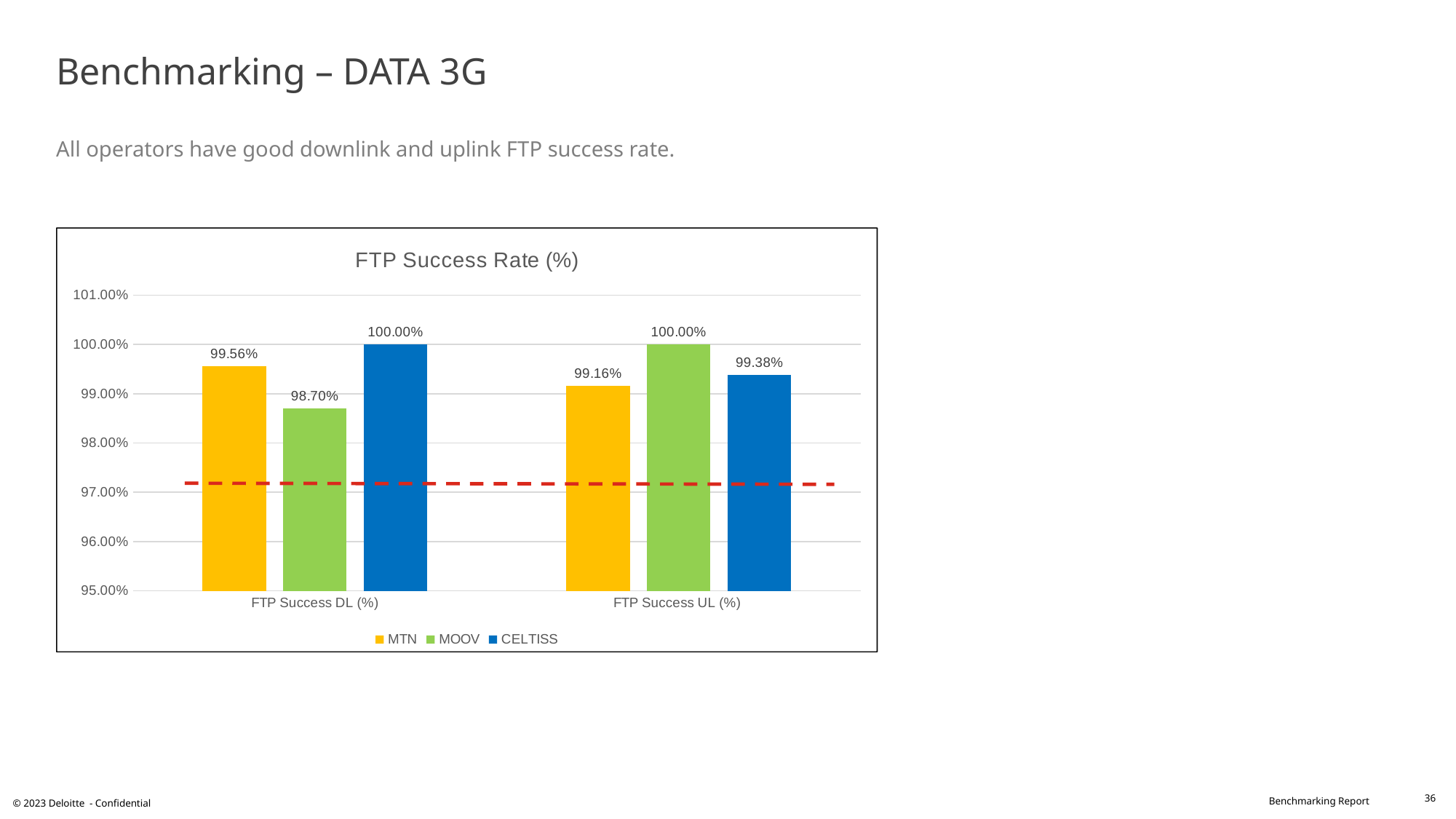
How many series does the legend list? 3 What is the title of the chart? FTP Success Rate (%) Which operator has the lowest FTP Success UL (%)? MTN How many categories are shown on the x axis? 2 What kind of chart is shown on the slide? Bar chart What is the FTP Success DL (%) value for MTN? 99.56% Which is larger: MTN's FTP Success DL (%) or MTN's FTP Success UL (%)? FTP Success DL (%) What is the FTP Success UL (%) value for CELTISS? 99.38% What is the FTP Success DL (%) value for MOOV? 98.70% Is the value for MOOV in FTP Success DL (%) greater or less than 99.00%? less Which operator has the highest FTP Success DL (%)? CELTISS What is the difference between CELTISS and MOOV for FTP Success DL (%)? 1.30%